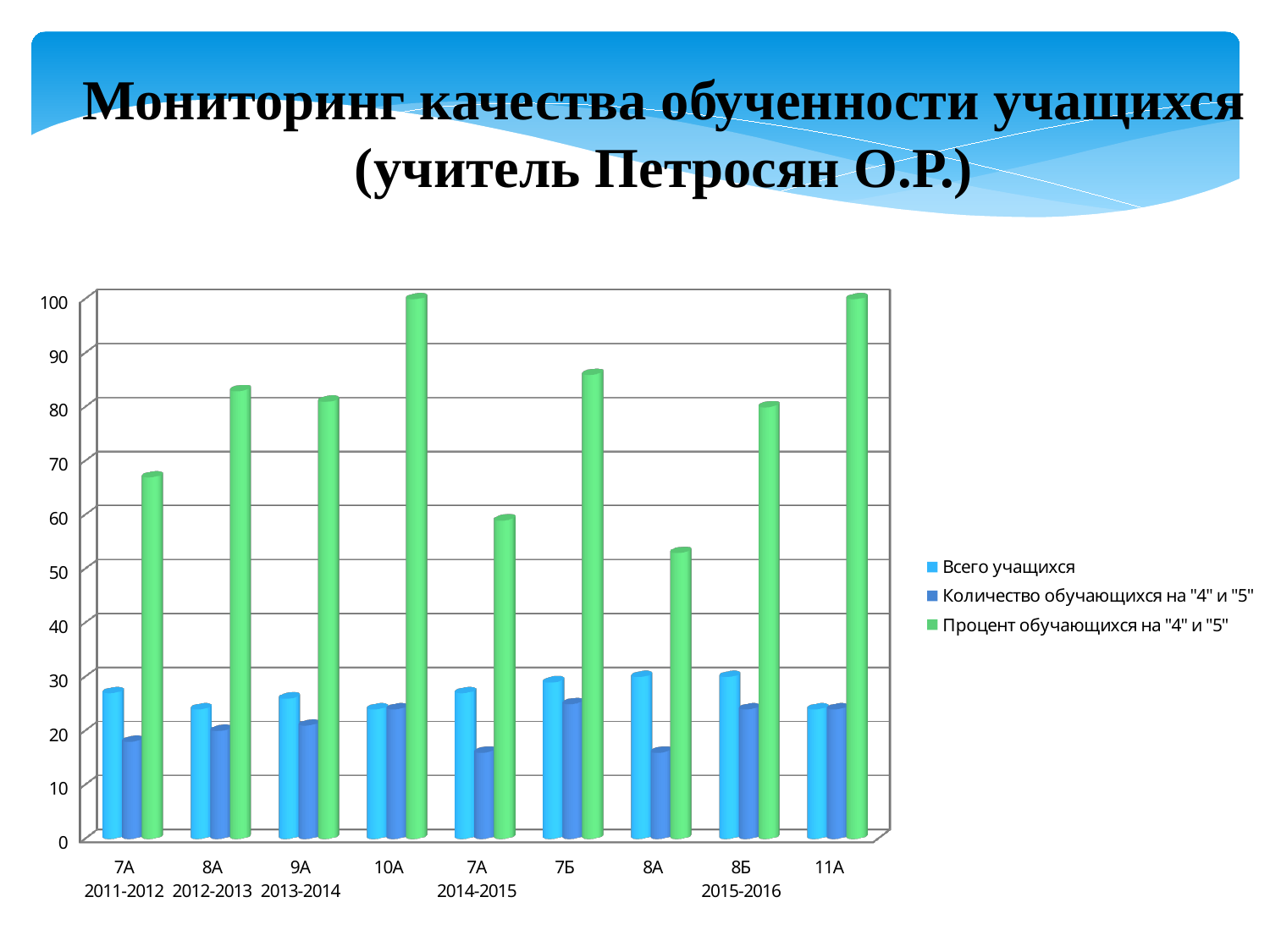
Is the value of "Процент обучающихся на "4" и "5"" for 8А 2015-2016 greater or less than 60? less Which has the larger value of "Количество обучающихся на "4" и "5"": 10А or 7А 2014-2015? 10А Is the value of "Всего учащихся" for 8А 2015-2016 greater or less than 20? greater Is the value of "Процент обучающихся на "4" и "5"" for 7Б greater or less than 80? greater Which category has the lowest value of "Процент обучающихся на "4" и "5""? 8А 2015-2016 What kind of chart is shown on the slide? bar chart Which has the larger value of "Процент обучающихся на "4" и "5"": 7А 2011-2012 or 8А 2012-2013? 8А 2012-2013 What colour are the bars for the series "Всего учащихся"? light blue How many series does the legend list? 3 How many class categories are shown along the x axis? 9